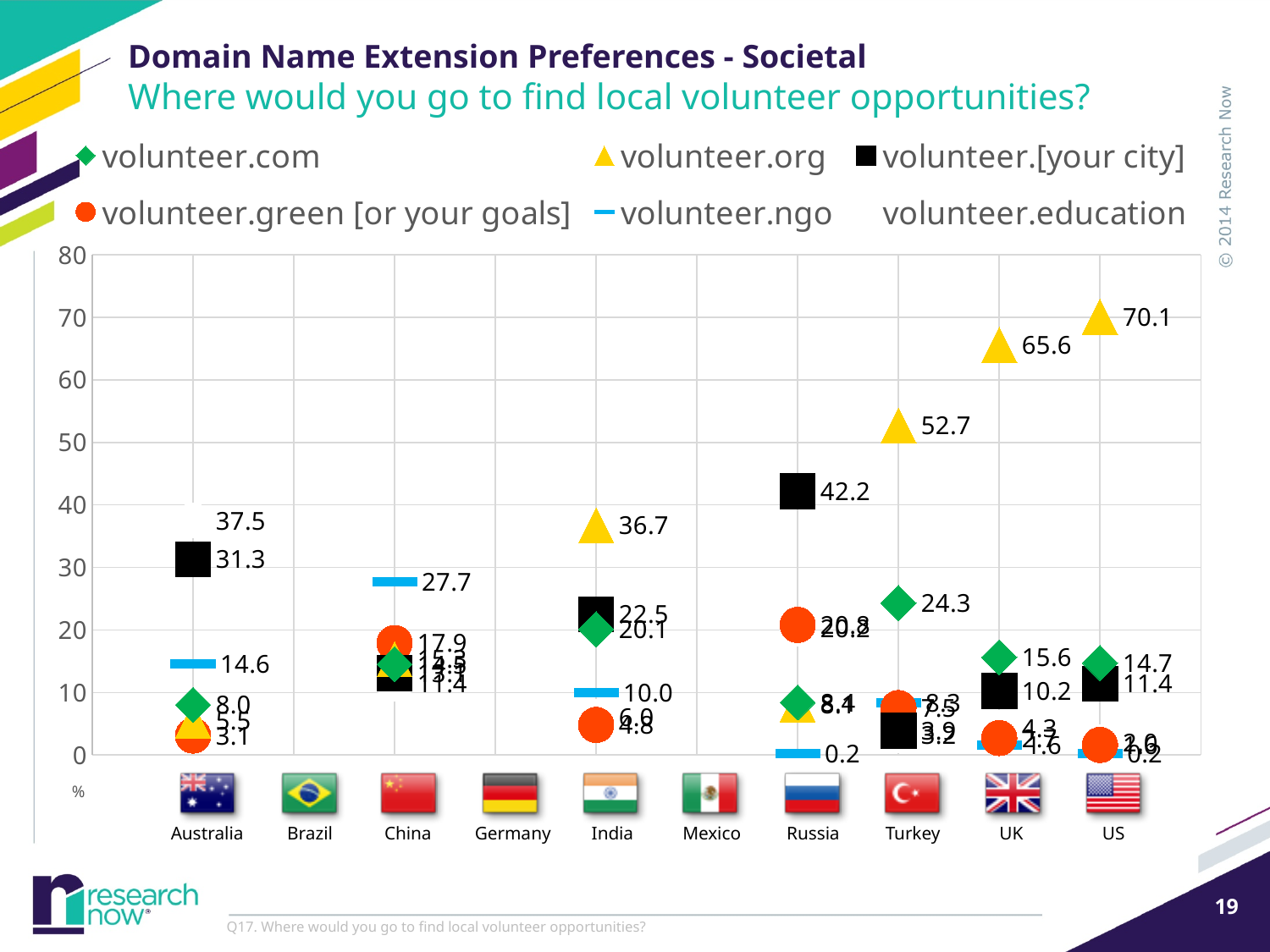
What is the value for volunteer.[your city] in Russia? 42.2 What is the value for volunteer.org in the UK? 65.6 Which is larger, the volunteer.org value for Turkey or for India? Turkey What is the difference between the volunteer.org values for the US and the UK? 4.5 How many series does the legend list? 6 What is the value for volunteer.org in the US? 70.1 What is the value for volunteer.com in Turkey? 24.3 Is the value for volunteer.[your city] in Russia greater or less than 40? greater What is the value for volunteer.[your city] in Australia? 31.3 Which country has the highest value for volunteer.org? US How many countries are shown on the x axis? 10 What is the value for volunteer.ngo in China? 27.7